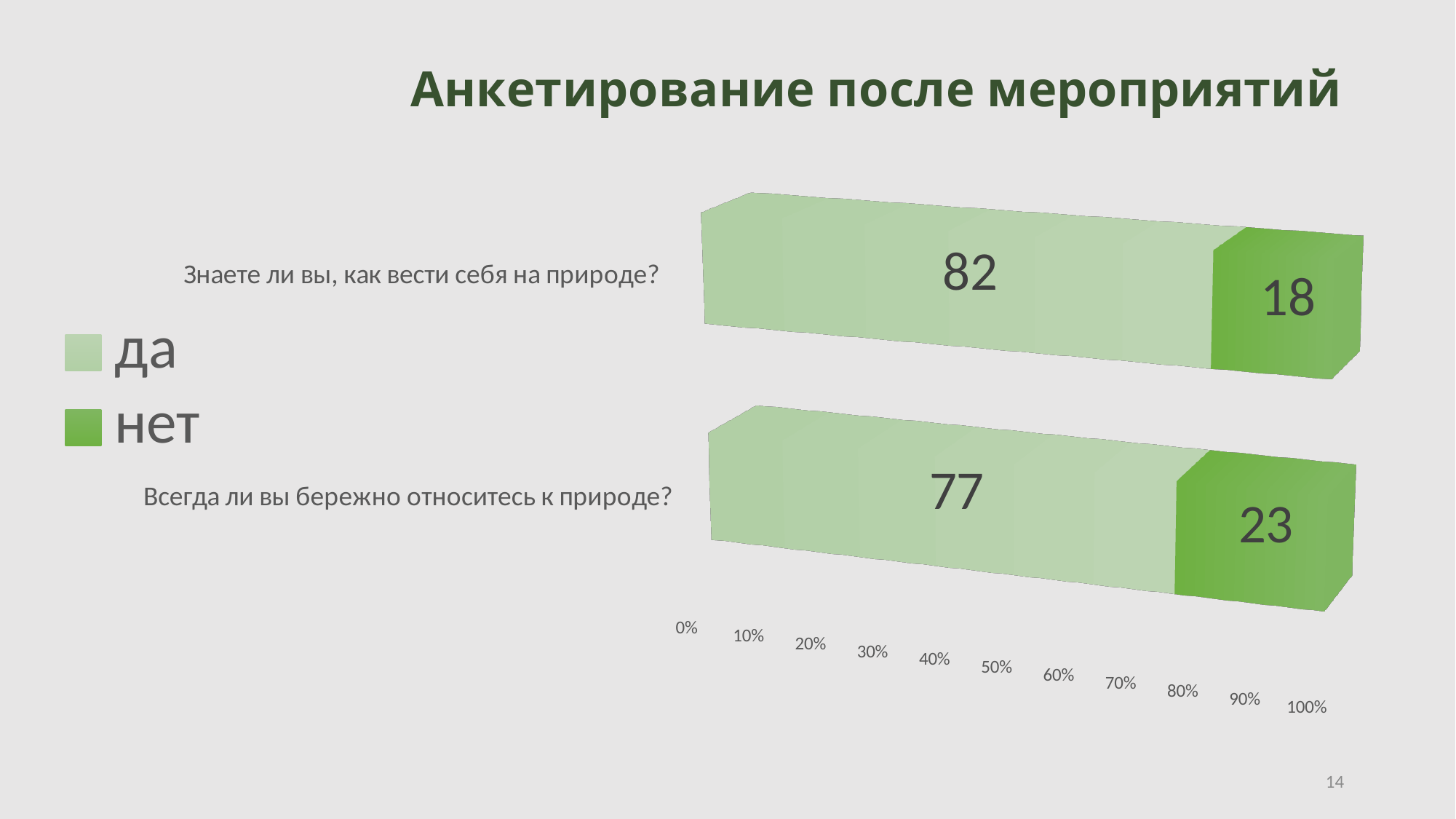
What is the total of the stacked bar for "Всегда ли вы бережно относитесь к природе?"? 100 What is the value for "нет" for the category "Всегда ли вы бережно относитесь к природе?"? 23 What is the value for "нет" for the category "Знаете ли вы, как вести себя на природе?"? 18 Which category has the highest value for "да"? Знаете ли вы, как вести себя на природе? How many categories are shown in the chart? 2 What is the value for "да" for the category "Всегда ли вы бережно относитесь к природе?"? 77 What is the difference between the "да" values for "Знаете ли вы, как вести себя на природе?" and "Всегда ли вы бережно относитесь к природе?"? 5 Which is larger: the "нет" value for "Всегда ли вы бережно относитесь к природе?" or the "нет" value for "Знаете ли вы, как вести себя на природе?"? Всегда ли вы бережно относитесь к природе? What is the value for "да" for the category "Знаете ли вы, как вести себя на природе?"? 82 What type of chart is shown on the slide? Stacked bar chart How many series does the legend list? 2 Which category has the lowest value for "нет"? Знаете ли вы, как вести себя на природе?